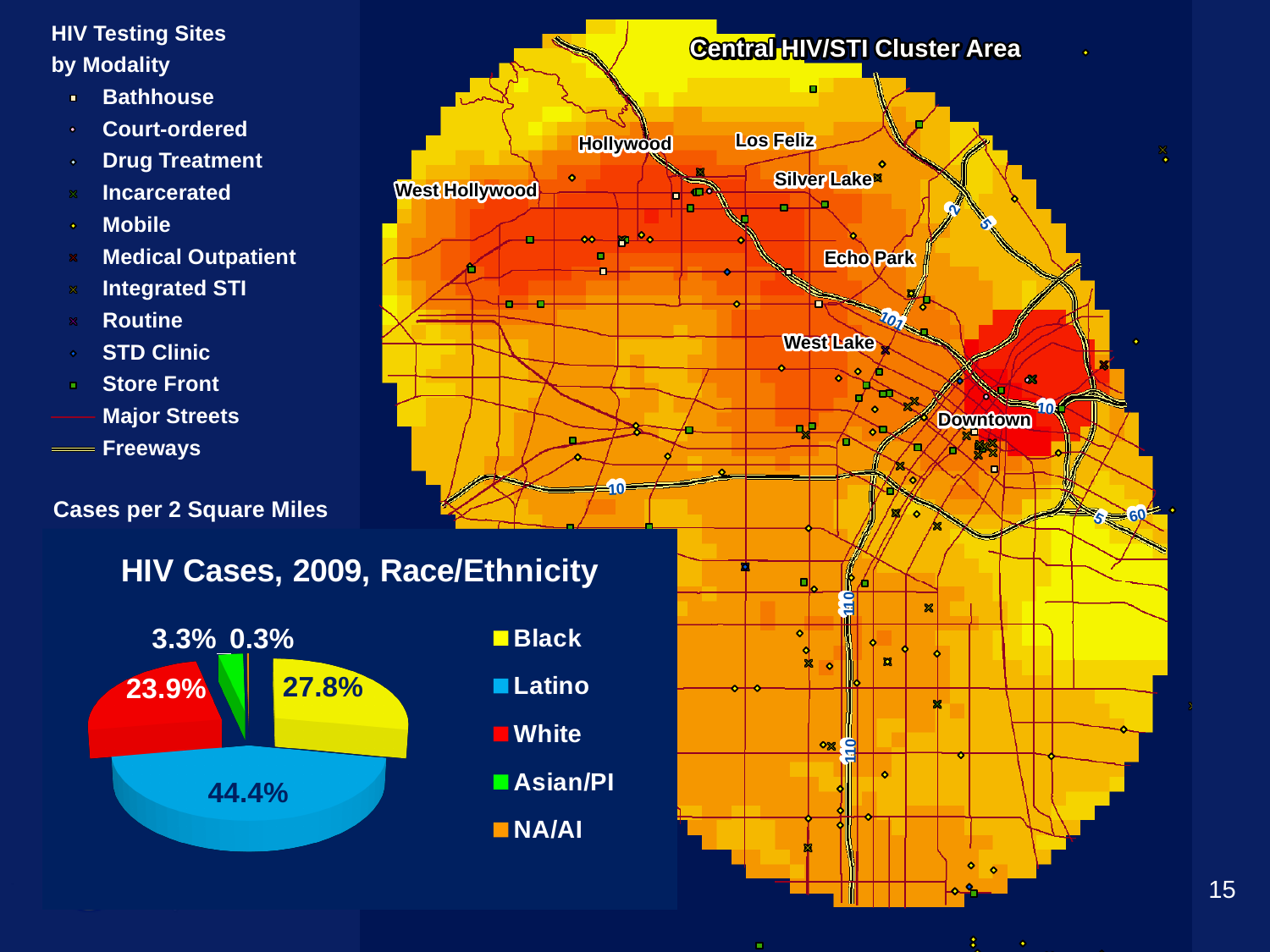
In the pie chart 'HIV Cases, 2009, Race/Ethnicity', what colour is the Latino slice? blue In the pie chart 'HIV Cases, 2009, Race/Ethnicity', how many percentage points larger is the Latino share than the Black share? 16.6 In the pie chart 'HIV Cases, 2009, Race/Ethnicity', which is larger, the Black share or the White share? Black In the pie chart 'HIV Cases, 2009, Race/Ethnicity', which race/ethnicity has the largest share? Latino In the pie chart 'HIV Cases, 2009, Race/Ethnicity', what share is NA/AI? 0.3% In the pie chart 'HIV Cases, 2009, Race/Ethnicity', what share is Latino? 44.4% In the pie chart 'HIV Cases, 2009, Race/Ethnicity', what share is Asian/PI? 3.3% In the pie chart 'HIV Cases, 2009, Race/Ethnicity', what share is Black? 27.8% How many race/ethnicity categories does the legend of the pie chart 'HIV Cases, 2009, Race/Ethnicity' list? 5 In the pie chart 'HIV Cases, 2009, Race/Ethnicity', which race/ethnicity has the smallest share? NA/AI What kind of chart is 'HIV Cases, 2009, Race/Ethnicity'? pie chart In the pie chart 'HIV Cases, 2009, Race/Ethnicity', what share is White? 23.9%